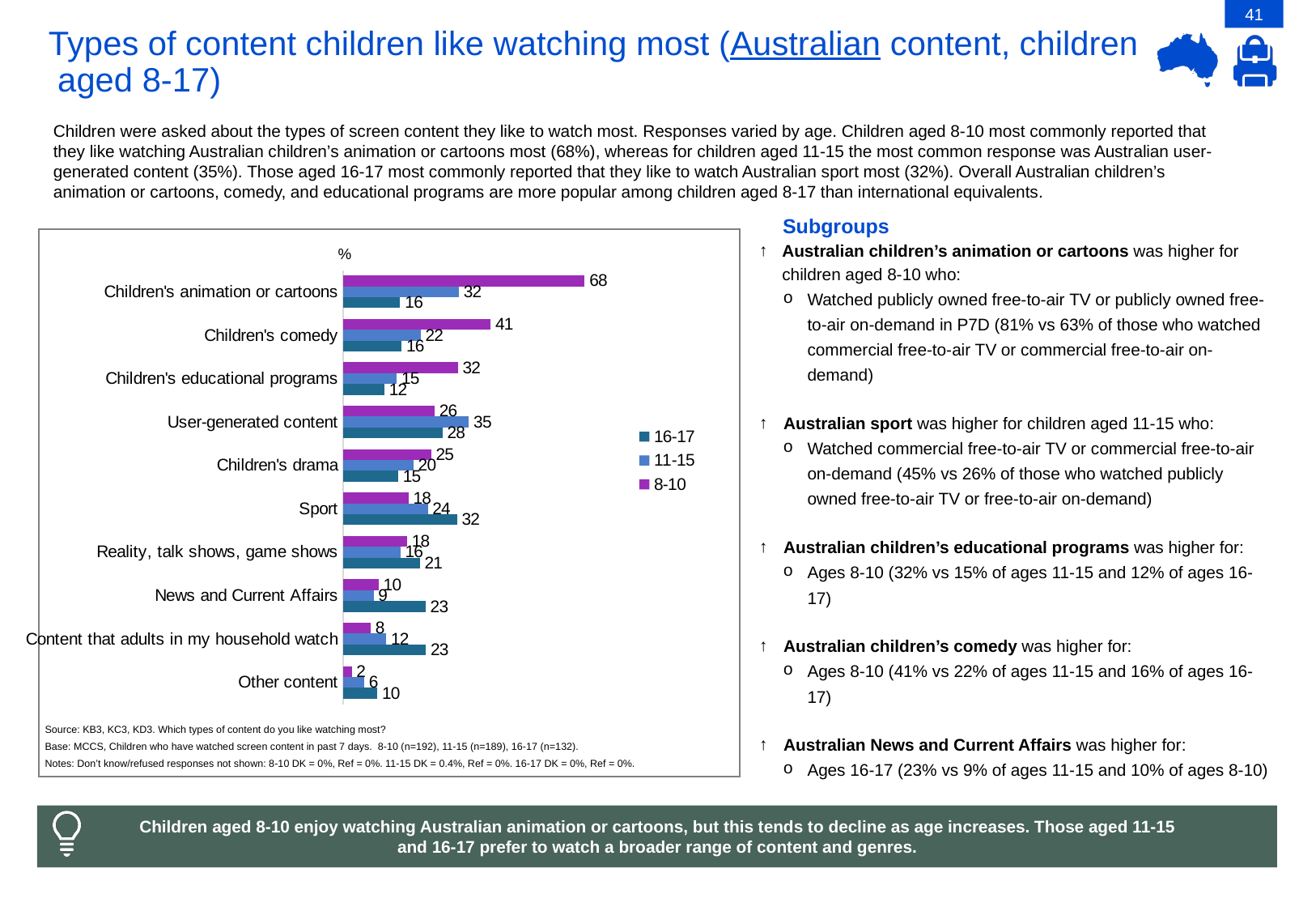
Which category has the highest value for the 16-17 age group? Sport What is the value for the 11-15 age group for User-generated content? 35 Which category has the lowest value for the 8-10 age group? Other content What is the value for the 11-15 age group for Content that adults in my household watch? 12 What is the difference between the 8-10 and 16-17 values for Children's comedy? 25 For News and Current Affairs, which age group has the larger value, 16-17 or 11-15? 16-17 What kind of chart is shown on the slide? Bar chart What is the value for the 8-10 age group for Children's animation or cartoons? 68 How many content categories are shown on the chart? 10 What is the value for the 16-17 age group for Sport? 32 How many series does the legend list? 3 Which age group is shown in purple in the legend? 8-10